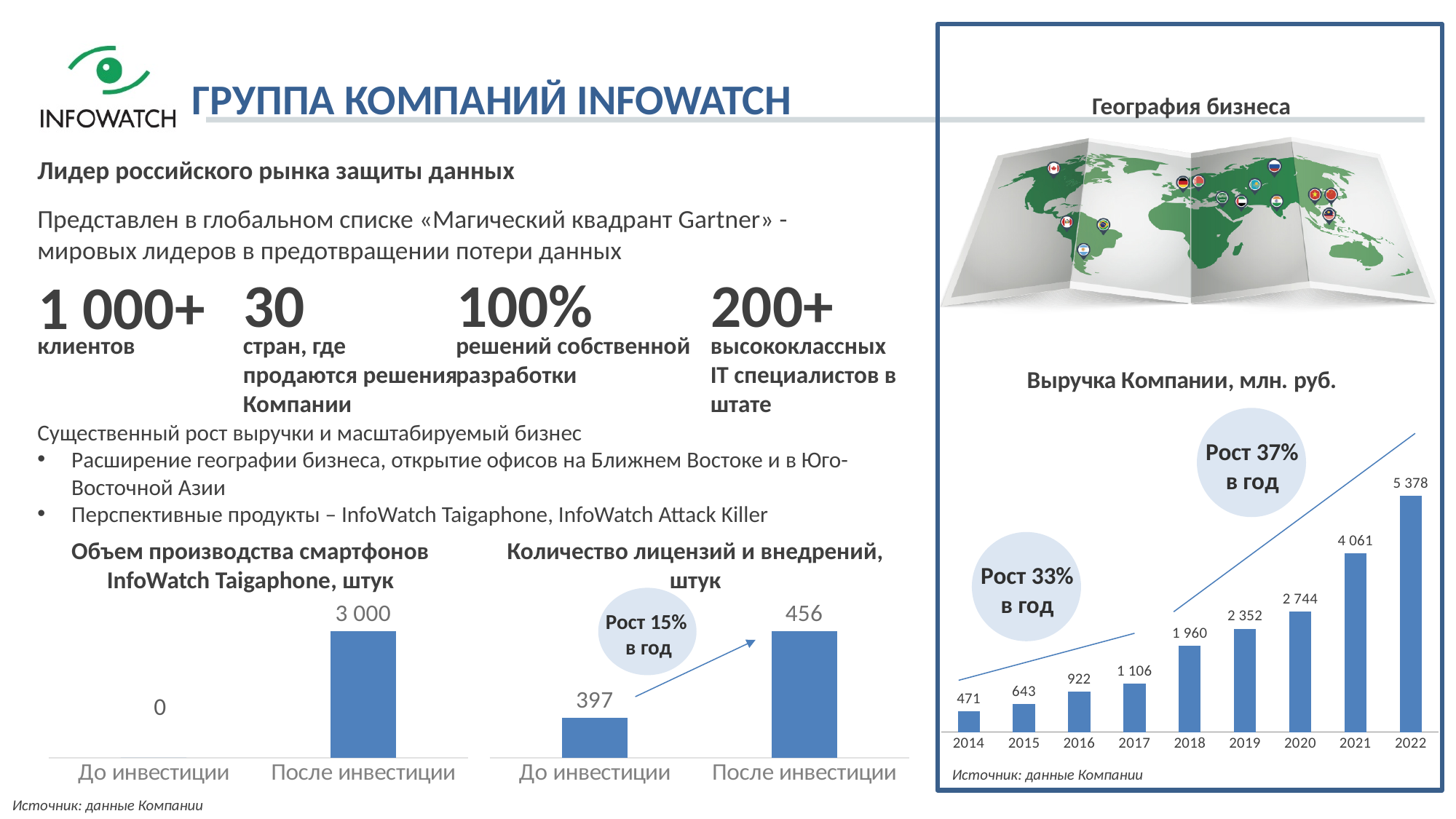
In the chart 'Выручка Компании, млн. руб.', do the values rise or fall from 2014 to 2022? rise In the chart 'Выручка Компании, млн. руб.', what is the difference between the values for 2022 and 2021? 1 317 In the chart 'Выручка Компании, млн. руб.', which year has the lowest value? 2014 What kind of chart is 'Выручка Компании, млн. руб.'? bar chart In the chart 'Количество лицензий и внедрений, штук', what is the value for 'После инвестиции'? 456 In the chart 'Количество лицензий и внедрений, штук', what is the difference between 'После инвестиции' and 'До инвестиции'? 59 In the chart 'Выручка Компании, млн. руб.', which year has the highest value? 2022 In the chart 'Выручка Компании, млн. руб.', what is the value for 2022? 5 378 In the chart 'Объем производства смартфонов InfoWatch Taigaphone, штук', which category is larger, 'До инвестиции' or 'После инвестиции'? После инвестиции In the chart 'Выручка Компании, млн. руб.', how many years are shown on the x axis? 9 In the chart 'Объем производства смартфонов InfoWatch Taigaphone, штук', what is the value for 'После инвестиции'? 3 000 In the chart 'Выручка Компании, млн. руб.', what is the value for 2018? 1 960